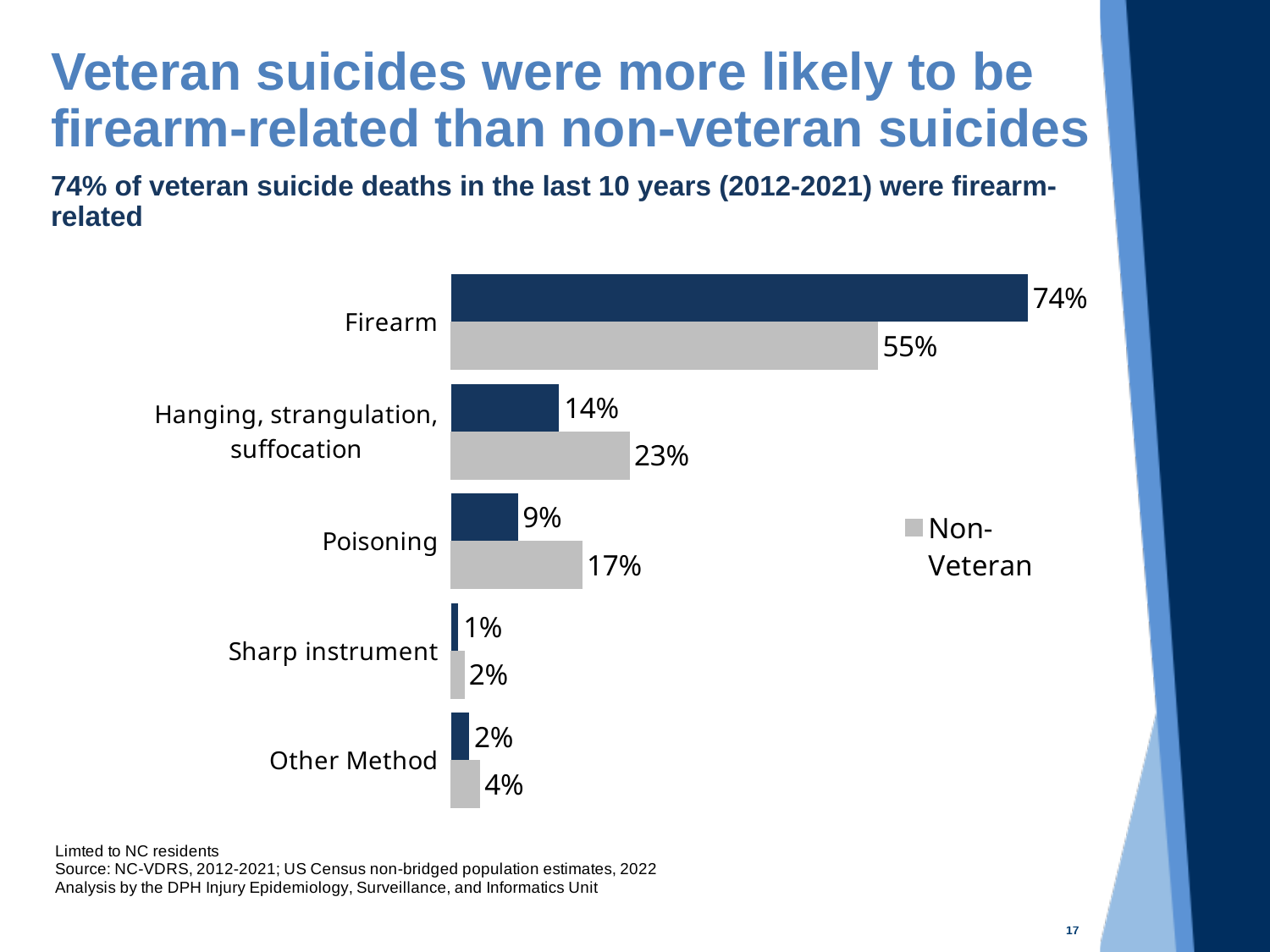
What colour represents the Non-Veteran series in the legend? Gray How many percentage points higher is the veteran Firearm value (74%) than the Non-Veteran Firearm value (55%)? 19 percentage points What percentage of non-veteran suicide deaths were firearm-related? 55% What is the Non-Veteran value for Poisoning? 17% How many method categories are shown on the chart? 5 What is the Non-Veteran value for Other Method? 4% Which method has the lowest Non-Veteran percentage? Sharp instrument For Poisoning, which is larger: the veteran (dark blue) value or the Non-Veteran value? Non-Veteran What is the value of the dark blue (veteran) bar for Hanging, strangulation, suffocation? 14% What type of chart is shown on the slide? Bar chart What percentage of veteran suicide deaths were firearm-related, according to the dark blue bar? 74% Which method has the highest Non-Veteran percentage? Firearm